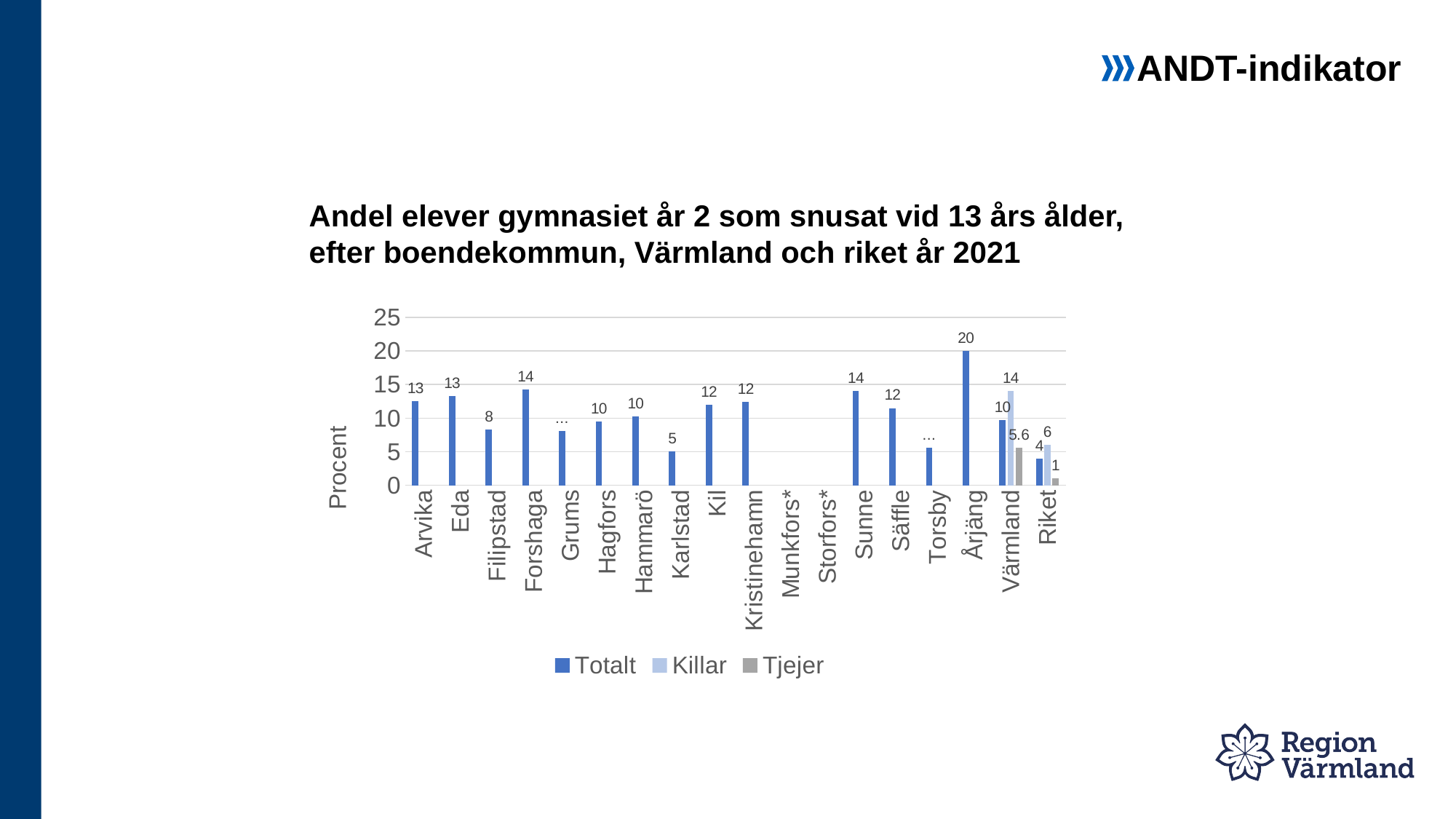
What kind of chart is shown on the slide? bar chart How many categories are shown on the x axis? 18 What is the Totalt value for Årjäng? 20 Which has a higher Totalt value, Forshaga or Filipstad? Forshaga What is the Tjejer value for Riket? 1 What is the Killar value for Värmland? 14 What is the difference between the Totalt values for Årjäng and Karlstad? 15 What is the Totalt value for Karlstad? 5 Is the Totalt value for Torsby greater or less than 10? less How many series does the legend list? 3 What is the Tjejer value for Värmland? 5.6 Which category has the highest Totalt value? Årjäng